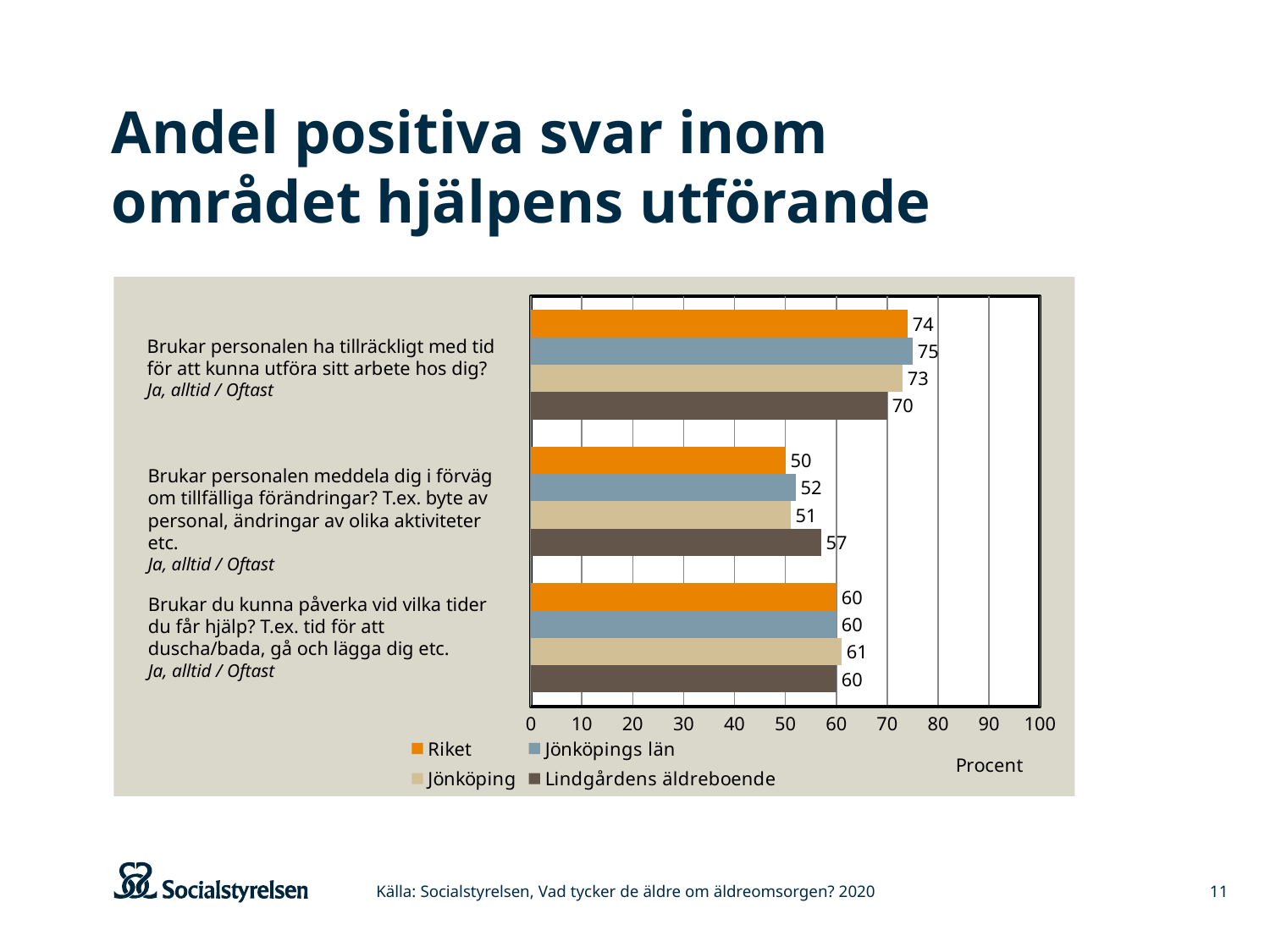
How many question categories are plotted on the chart? 3 What kind of chart is shown on the slide? Bar chart Which series has the lowest value on the question "Brukar personalen meddela dig i förväg om tillfälliga förändringar?"? Riket On the question "Brukar personalen meddela dig i förväg om tillfälliga förändringar?", which is larger: Lindgårdens äldreboende or Jönköpings län? Lindgårdens äldreboende What is the value for Lindgårdens äldreboende on the question "Brukar personalen meddela dig i förväg om tillfälliga förändringar?"? 57 What is the difference between Jönköpings län and Lindgårdens äldreboende on the question "Brukar personalen ha tillräckligt med tid för att kunna utföra sitt arbete hos dig?"? 5 What is the value for Riket on the question "Brukar personalen ha tillräckligt med tid för att kunna utföra sitt arbete hos dig?"? 74 What is the label of the horizontal axis? Procent What is the value for Jönköping on the question "Brukar du kunna påverka vid vilka tider du får hjälp?"? 61 Which series has the highest value on the question "Brukar personalen ha tillräckligt med tid för att kunna utföra sitt arbete hos dig?"? Jönköpings län What is the difference between Lindgårdens äldreboende and Riket on the question "Brukar personalen meddela dig i förväg om tillfälliga förändringar?"? 7 How many series does the legend list? 4